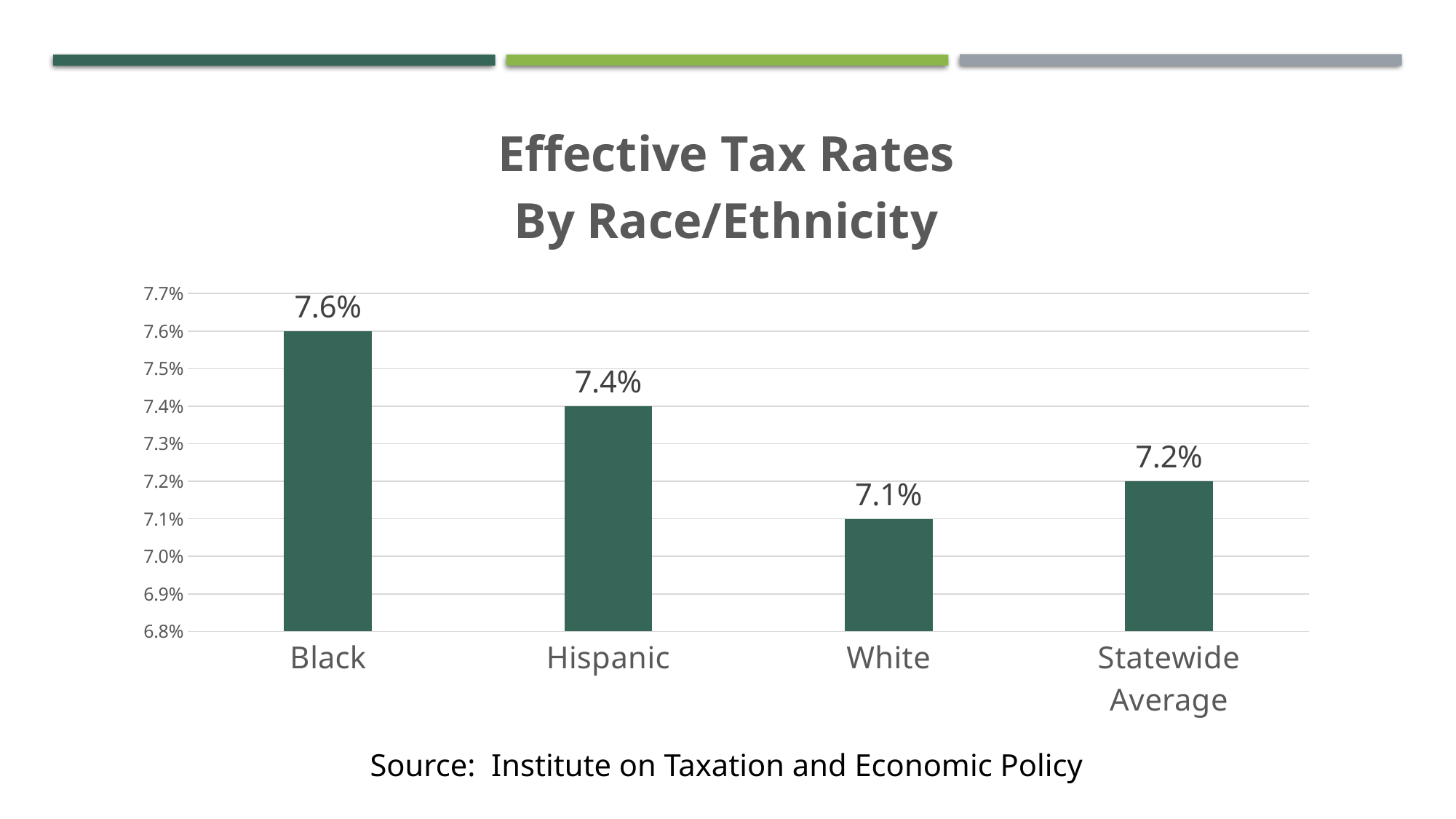
What is the difference between the Hispanic effective tax rate and the Statewide Average? 0.2% What is the Statewide Average effective tax rate? 7.2% Which category has the highest effective tax rate? Black What is the difference between the effective tax rate for Black taxpayers and for White taxpayers? 0.5% What kind of chart is shown on the slide? Bar chart What is the effective tax rate for White taxpayers? 7.1% How many categories are shown on the chart? 4 Which is larger, the effective tax rate for Hispanic taxpayers or the Statewide Average? Hispanic Which category has the lowest effective tax rate? White What is the effective tax rate for Black taxpayers? 7.6% What is the title of the chart? Effective Tax Rates By Race/Ethnicity What is the effective tax rate for Hispanic taxpayers? 7.4%